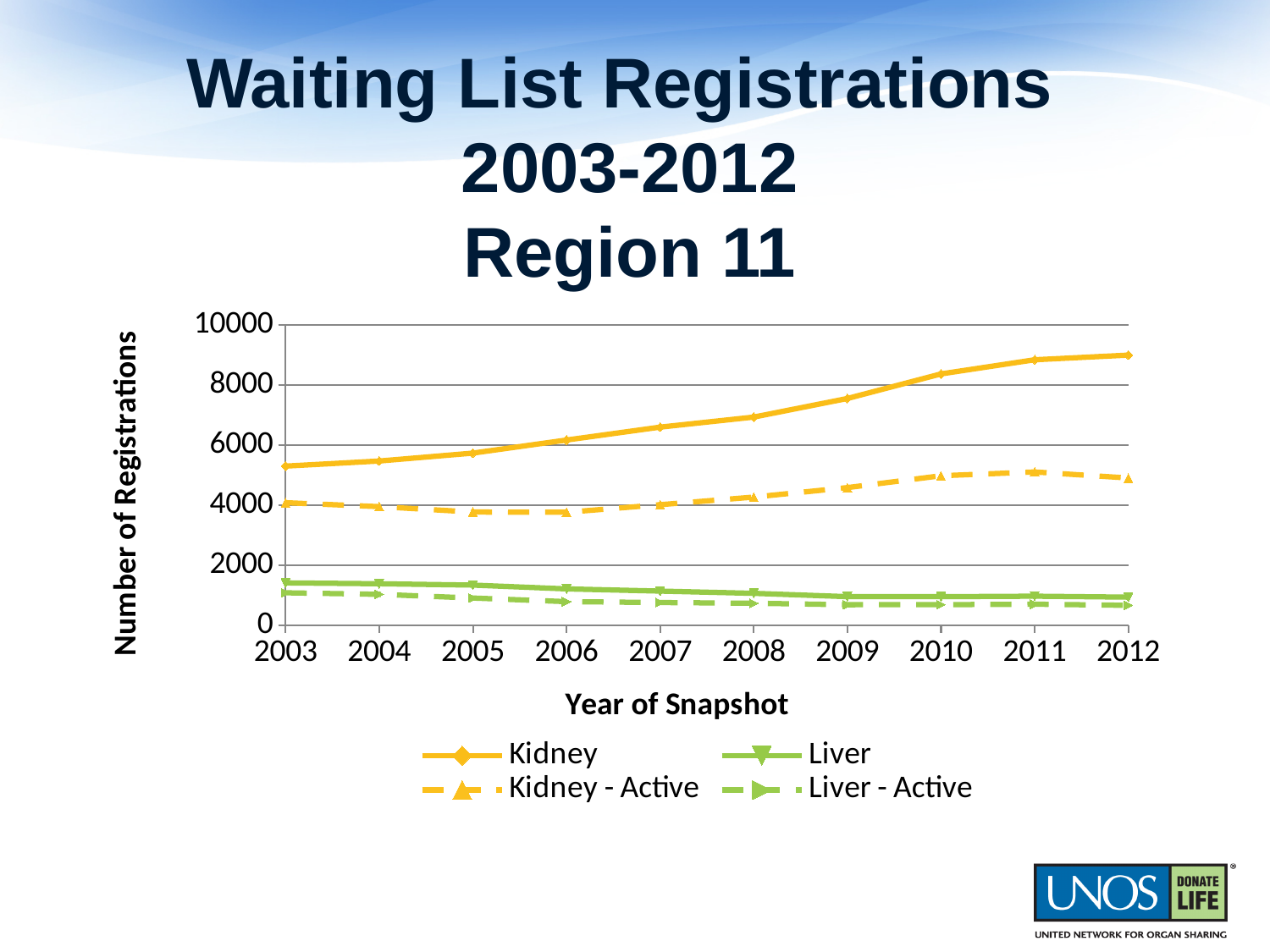
How many years are plotted along the x axis? 10 Is the value for Liver in 2003 greater or less than 2000? less Does the Kidney series rise or fall from 2003 to 2012? rise What is the title of the y axis? Number of Registrations Is the value for Kidney - Active in 2011 greater or less than 4000? greater Is the value for Kidney in 2003 greater or less than 4000? greater How many series does the legend list? 4 What kind of chart is shown on the slide? line chart In which year is the Kidney series at its lowest? 2003 Does the Liver series rise or fall from 2003 to 2012? fall Which series is larger in 2012, Kidney or Liver? Kidney